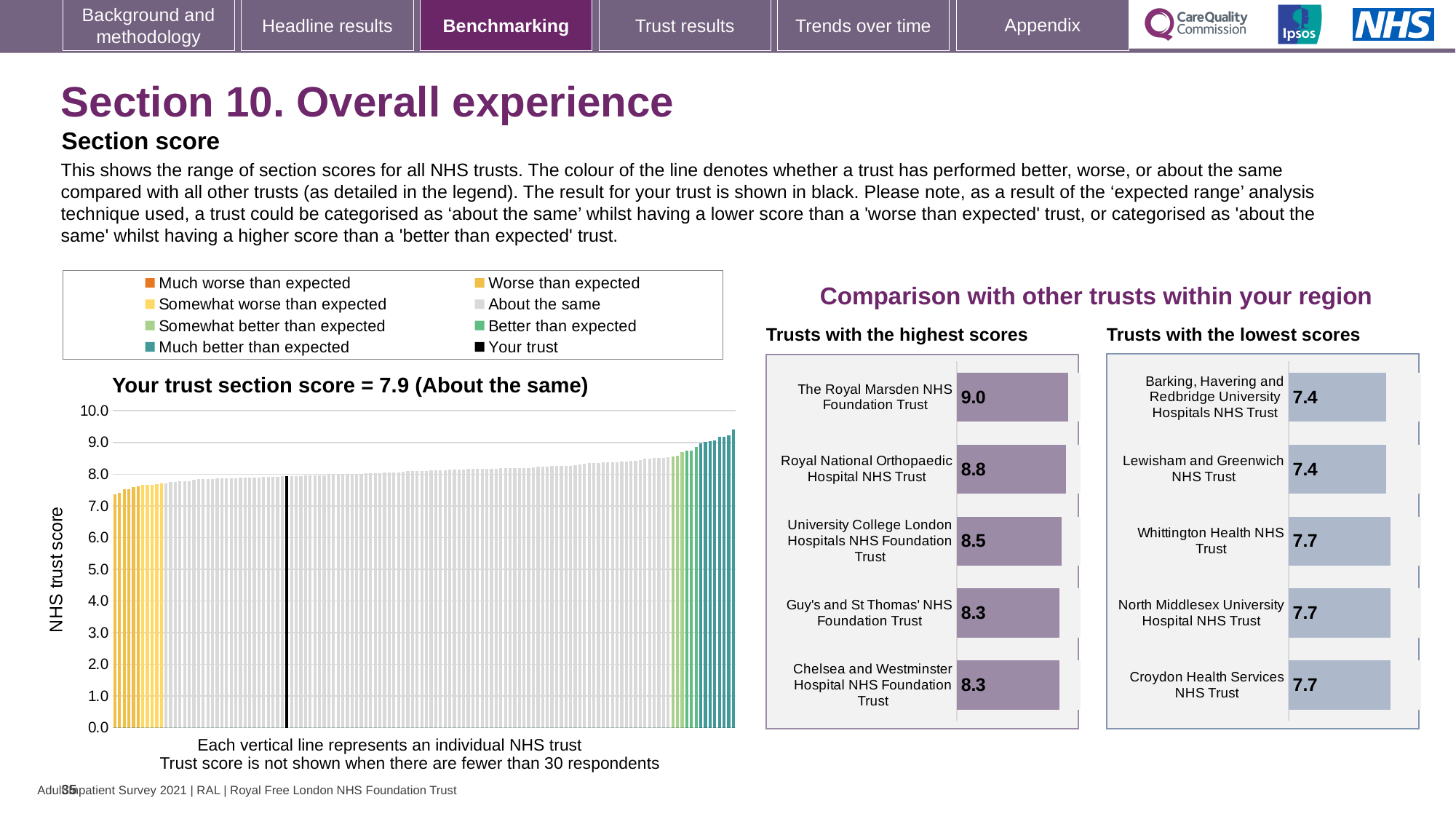
In the 'Trusts with the highest scores' chart, what is the score for The Royal Marsden NHS Foundation Trust? 9.0 In the 'Your trust section score' chart, what is the section score for your trust? 7.9 In the 'Your trust section score' chart, do the trust scores rise or fall from left to right? rise In the 'Trusts with the lowest scores' chart, what is the difference between the scores of Croydon Health Services NHS Trust and Barking, Havering and Redbridge University Hospitals NHS Trust? 0.3 In the 'Trusts with the lowest scores' chart, which has the higher score, Lewisham and Greenwich NHS Trust or Croydon Health Services NHS Trust? Croydon Health Services NHS Trust In the 'Trusts with the highest scores' chart, what is the difference between the scores of The Royal Marsden NHS Foundation Trust and Royal National Orthopaedic Hospital NHS Trust? 0.2 In the 'Trusts with the highest scores' chart, how many trusts are shown? 5 In the 'Your trust section score' chart, what kind of chart is shown? bar chart In the 'Your trust section score' chart, what is the label on the vertical axis? NHS trust score In the 'Your trust section score' chart, how many entries does the legend list? 8 In the 'Trusts with the lowest scores' chart, what is the score for Whittington Health NHS Trust? 7.7 In the 'Your trust section score' chart, is the value of the leftmost bar greater or less than 8.0? less